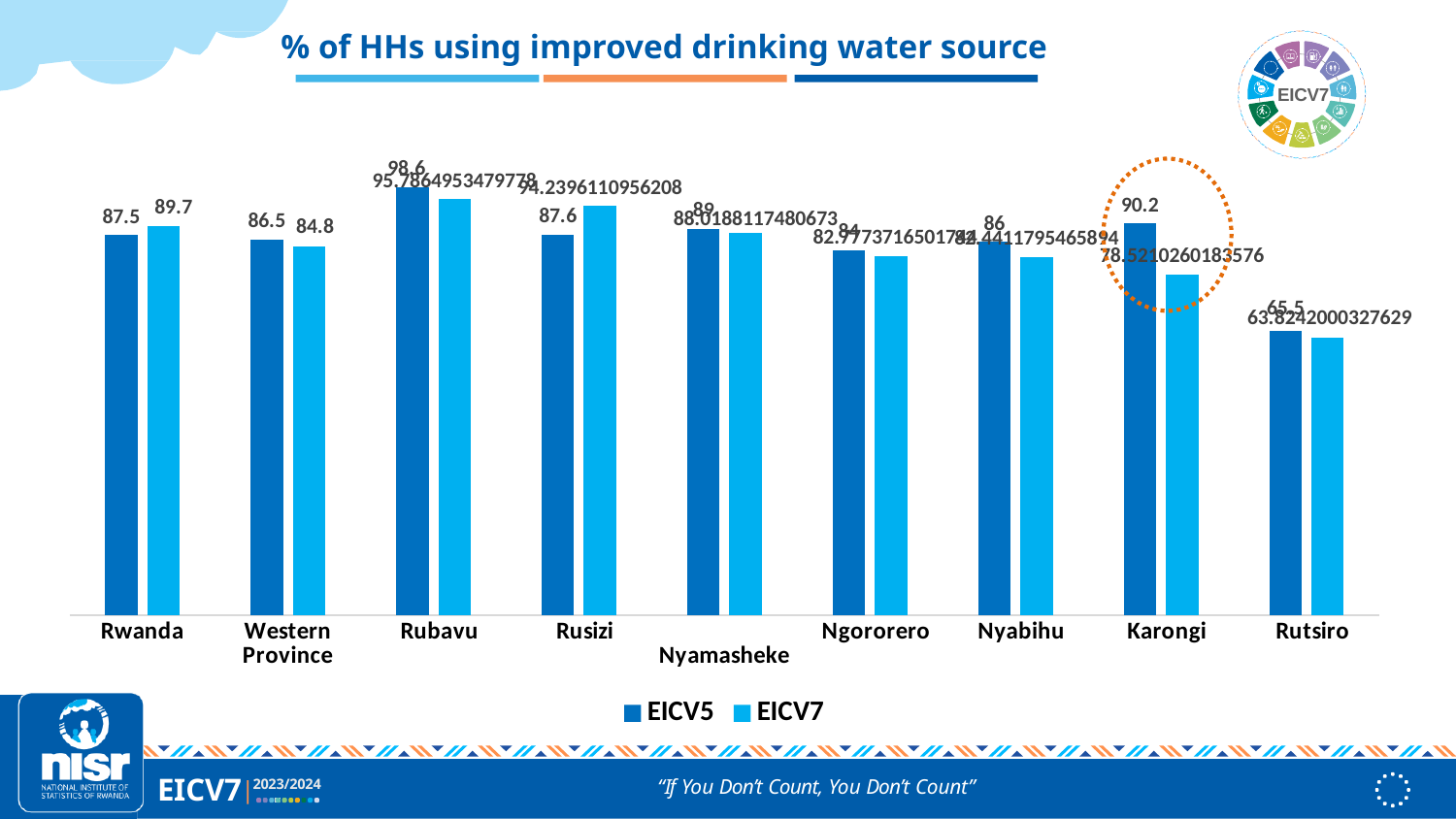
What is the difference between the EICV7 and EICV5 values for Rwanda? 2.2 What is the EICV5 value for Western Province? 86.5 Which category has the highest EICV5 value? Rubavu What type of chart is shown on the slide? Bar chart How many categories are shown on the x axis? 9 How many series does the legend list? 2 For Karongi, which is larger, the EICV5 value or the EICV7 value? EICV5 What is the EICV7 value for Rwanda? 89.7 What is the EICV5 value for Karongi? 90.2 Which category is highlighted with a dotted orange circle? Karongi What is the EICV5 value for Rutsiro? 65.5 Which category has the lowest EICV7 value? Rutsiro